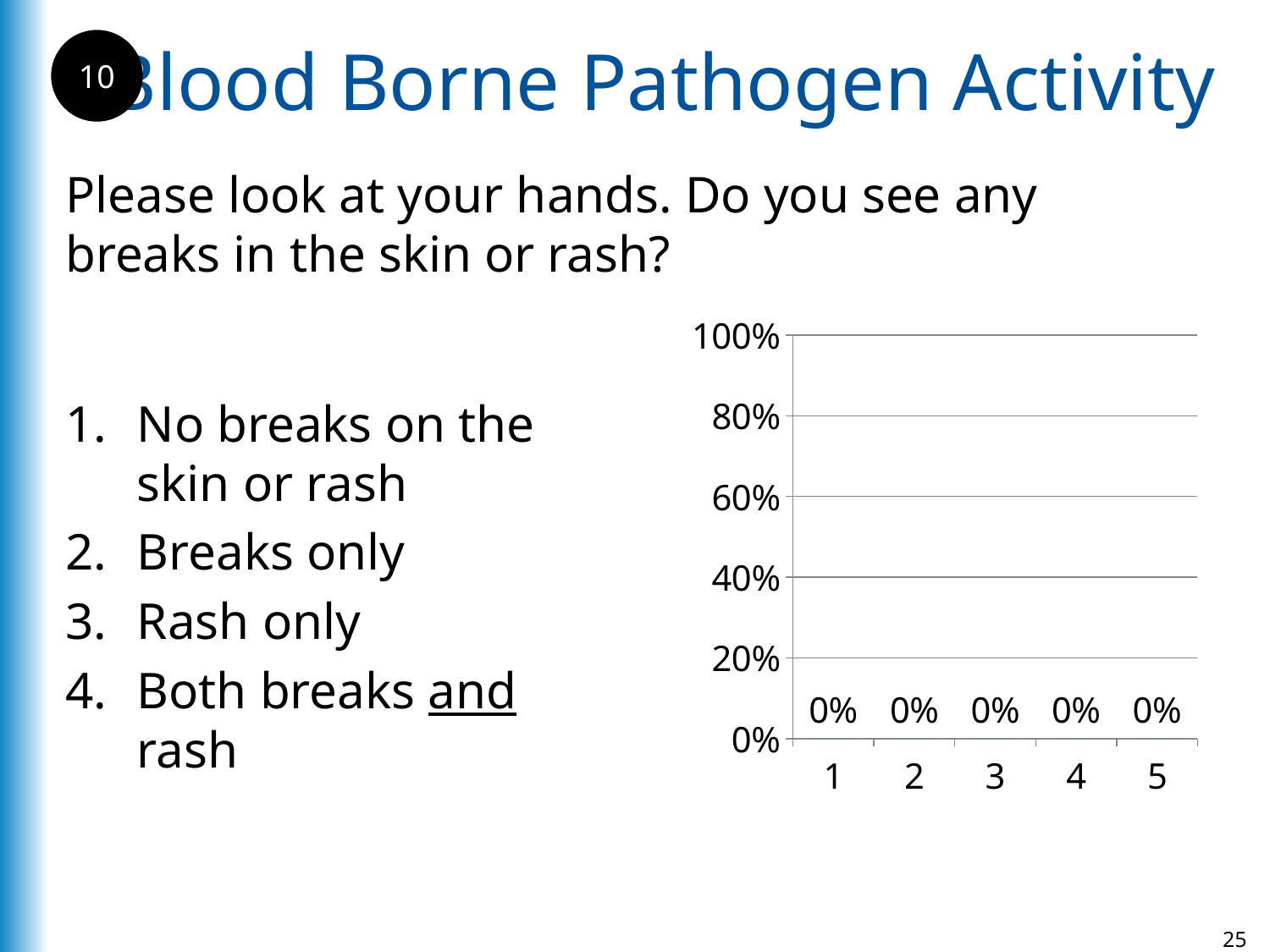
Is the value for category 2 greater or less than 20%? less Do the values rise, fall, or stay flat from category 1 to category 5? stay flat Is the value for category 4 greater or less than 40%? less What is the value shown for category 1? 0% What is the interval between tick labels on the y axis of the chart? 20% How many categories are shown on the x axis of the chart? 5 What is the highest tick label on the y axis of the chart? 100% What kind of chart is shown on the slide? bar chart What is the difference between the values for category 1 and category 5? 0% What is the value shown for category 5? 0% What is the value shown for category 3? 0%